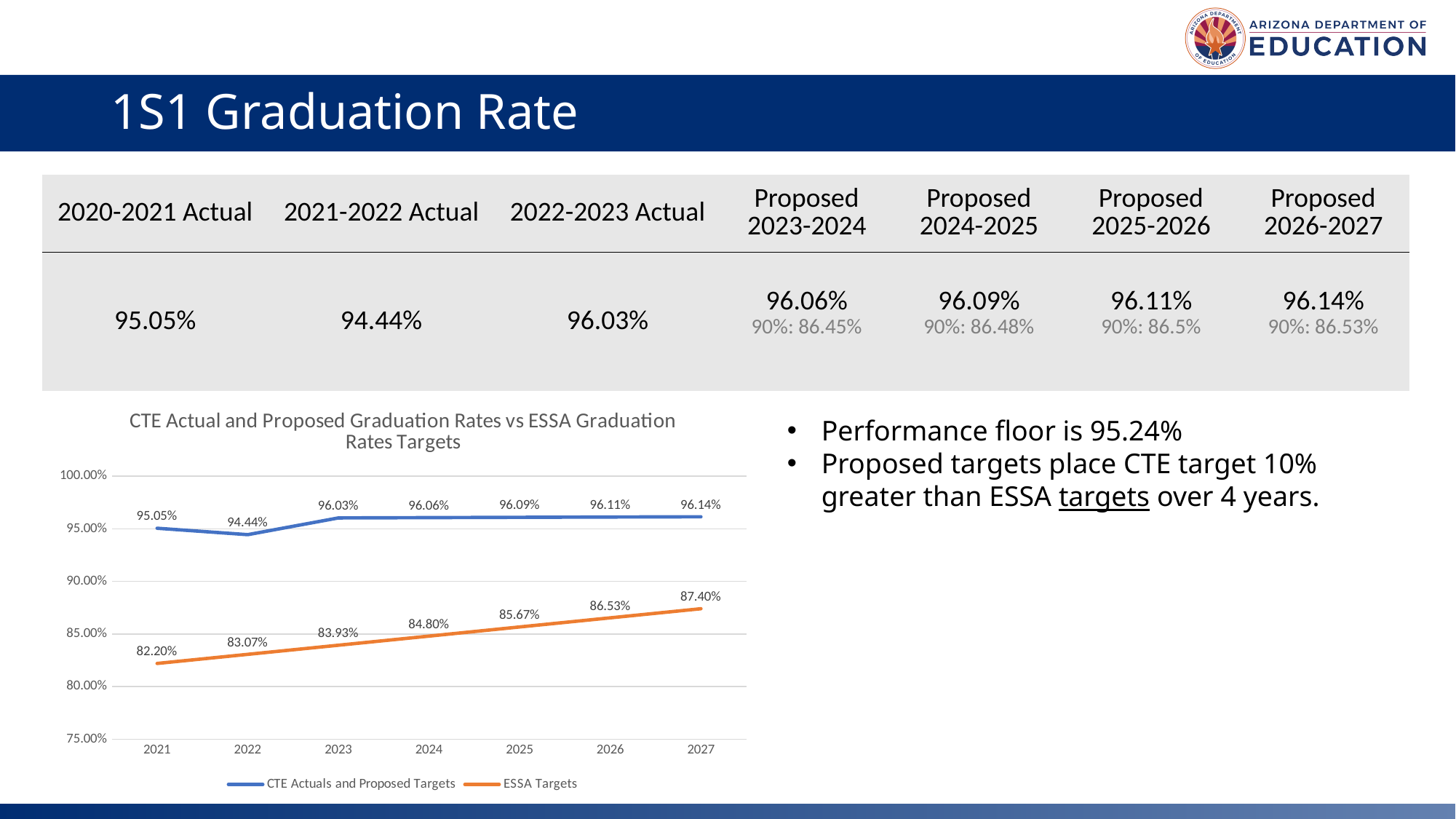
Which year has the lowest ESSA Targets value? 2021 What kind of chart is shown on the slide? line chart What is the value of CTE Actuals and Proposed Targets for 2021? 95.05% What is the value of CTE Actuals and Proposed Targets for 2022? 94.44% Which year has the lowest value for CTE Actuals and Proposed Targets? 2022 How many years are plotted on the x axis? 7 What is the ESSA Targets value for 2027? 87.40% Which is larger in 2023: the CTE Actuals and Proposed Targets value or the ESSA Targets value? CTE Actuals and Proposed Targets What is the difference between the CTE Actuals and Proposed Targets value and the ESSA Targets value in 2027? 8.74% Is the ESSA Targets value for 2025 greater or less than 90.00%? less How many series does the legend list? 2 What is the ESSA Targets value for 2024? 84.80%